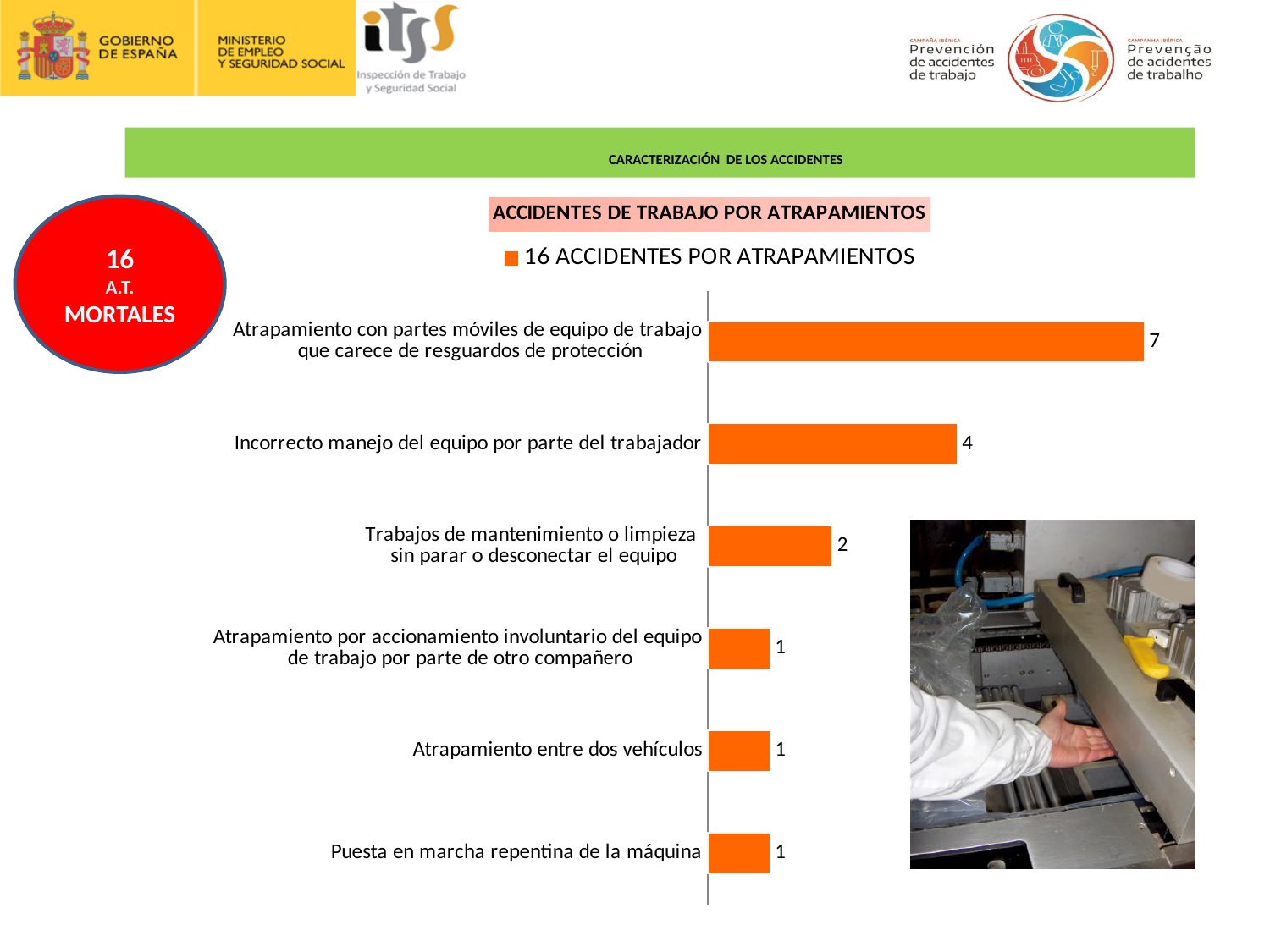
How many categories are shown in the chart? 6 What is the value for "Incorrecto manejo del equipo por parte del trabajador"? 4 What is the value for "Puesta en marcha repentina de la máquina"? 1 What is the legend entry of the chart? 16 ACCIDENTES POR ATRAPAMIENTOS What is the difference between the values for "Atrapamiento con partes móviles de equipo de trabajo que carece de resguardos de protección" and "Incorrecto manejo del equipo por parte del trabajador"? 3 What colour are the bars in the chart? orange What is the value for "Atrapamiento con partes móviles de equipo de trabajo que carece de resguardos de protección"? 7 Which is larger: the value for "Incorrecto manejo del equipo por parte del trabajador" or the value for "Trabajos de mantenimiento o limpieza sin parar o desconectar el equipo"? Incorrecto manejo del equipo por parte del trabajador What is the value for "Trabajos de mantenimiento o limpieza sin parar o desconectar el equipo"? 2 How many series does the legend list? 1 What kind of chart is shown on the slide? bar chart Which category has the highest value? Atrapamiento con partes móviles de equipo de trabajo que carece de resguardos de protección